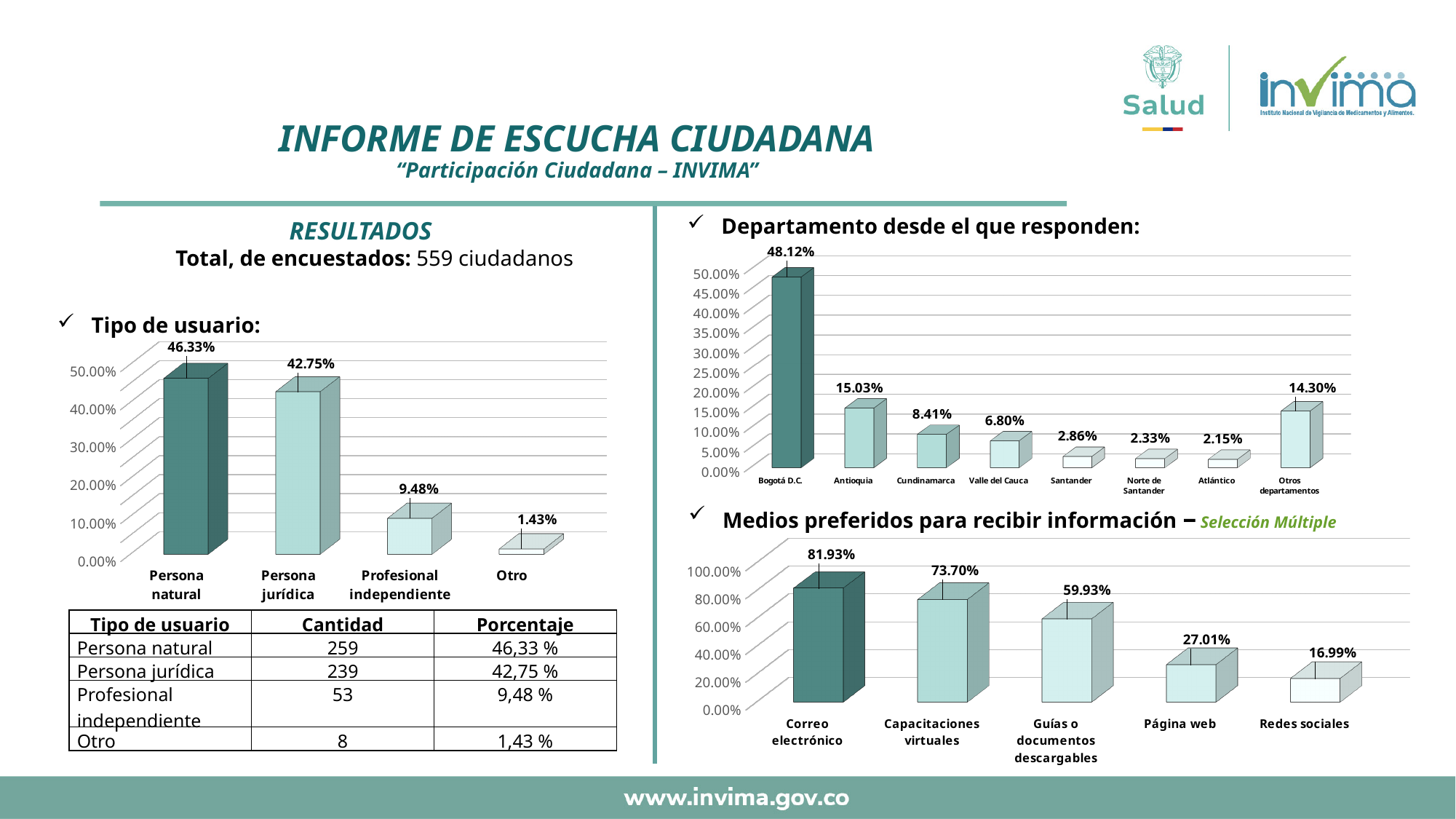
In the 'Departamento desde el que responden' chart, which is larger: Cundinamarca or Valle del Cauca? Cundinamarca In the 'Medios preferidos para recibir información' chart, what is the value for Página web? 27.01% What kind of chart is the 'Medios preferidos para recibir información' chart? bar chart In the 'Medios preferidos para recibir información' chart, do the values rise or fall from left to right? fall In the 'Tipo de usuario' chart, how many categories are shown? 4 In the 'Tipo de usuario' chart, what is the value for Persona natural? 46.33% In the 'Medios preferidos para recibir información' chart, which category has the lowest value? Redes sociales In the 'Departamento desde el que responden' chart, how many categories are shown? 8 In the 'Tipo de usuario' chart, which category has the lowest value? Otro In the 'Departamento desde el que responden' chart, which department has the highest value? Bogotá D.C. In the 'Tipo de usuario' chart, what is the difference between Persona natural and Persona jurídica? 3.58% In the 'Departamento desde el que responden' chart, what is the value for Antioquia? 15.03%